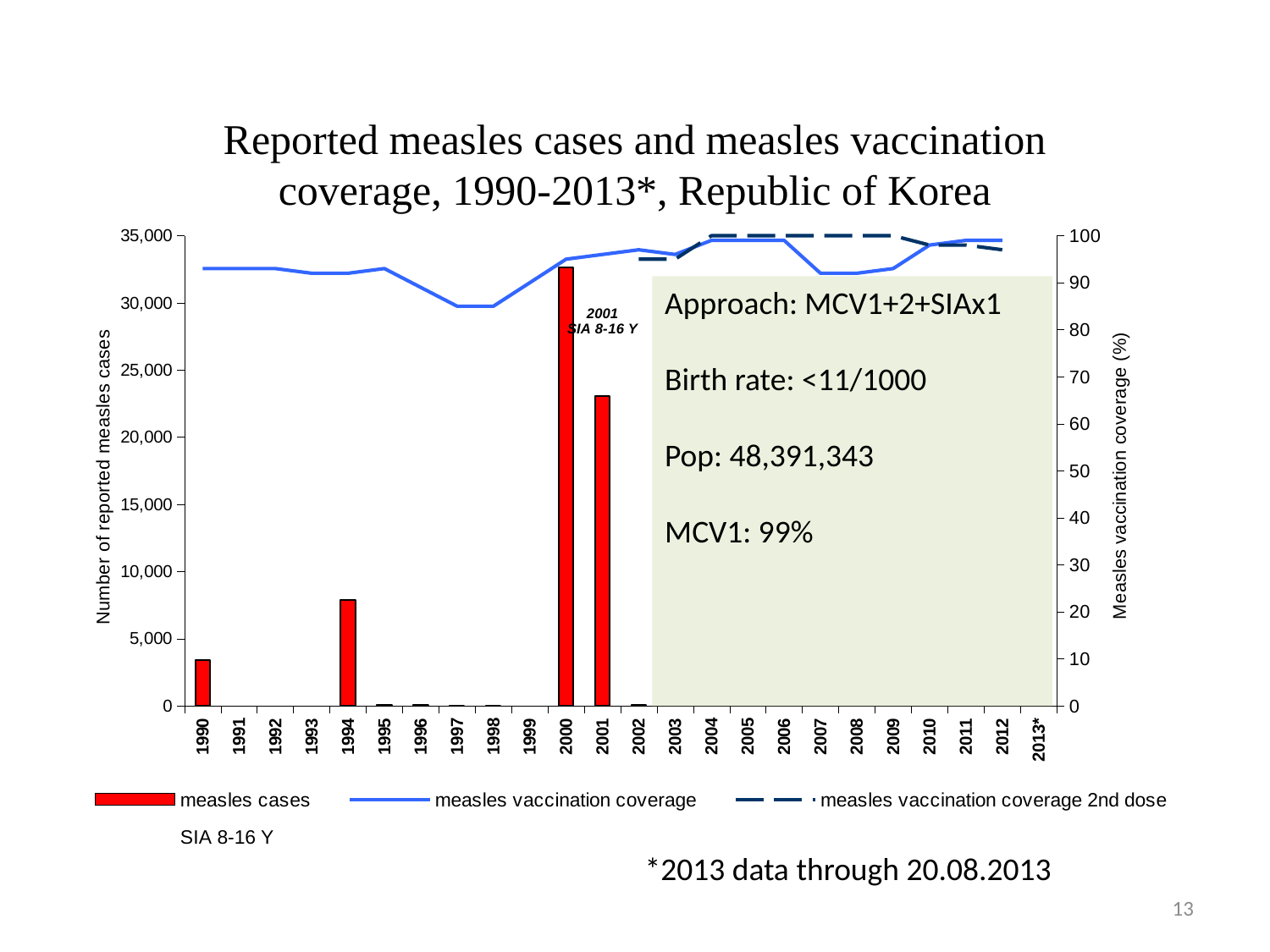
What type of chart is shown on the slide? Combined bar and line chart How many years are shown on the x axis? 24 Is the number of reported measles cases in 2001 greater or less than 20,000? greater Is the number of reported measles cases in 2000 greater or less than 30,000? greater Is the number of reported measles cases in 1990 greater or less than 5,000? less Does the measles vaccination coverage line rise or fall from 1998 to 2004? rise In which year is the number of reported measles cases highest? 2000 Which series is drawn as a dashed line in the legend? measles vaccination coverage 2nd dose Which year had more reported measles cases, 2000 or 2001? 2000 How many series does the legend list? 4